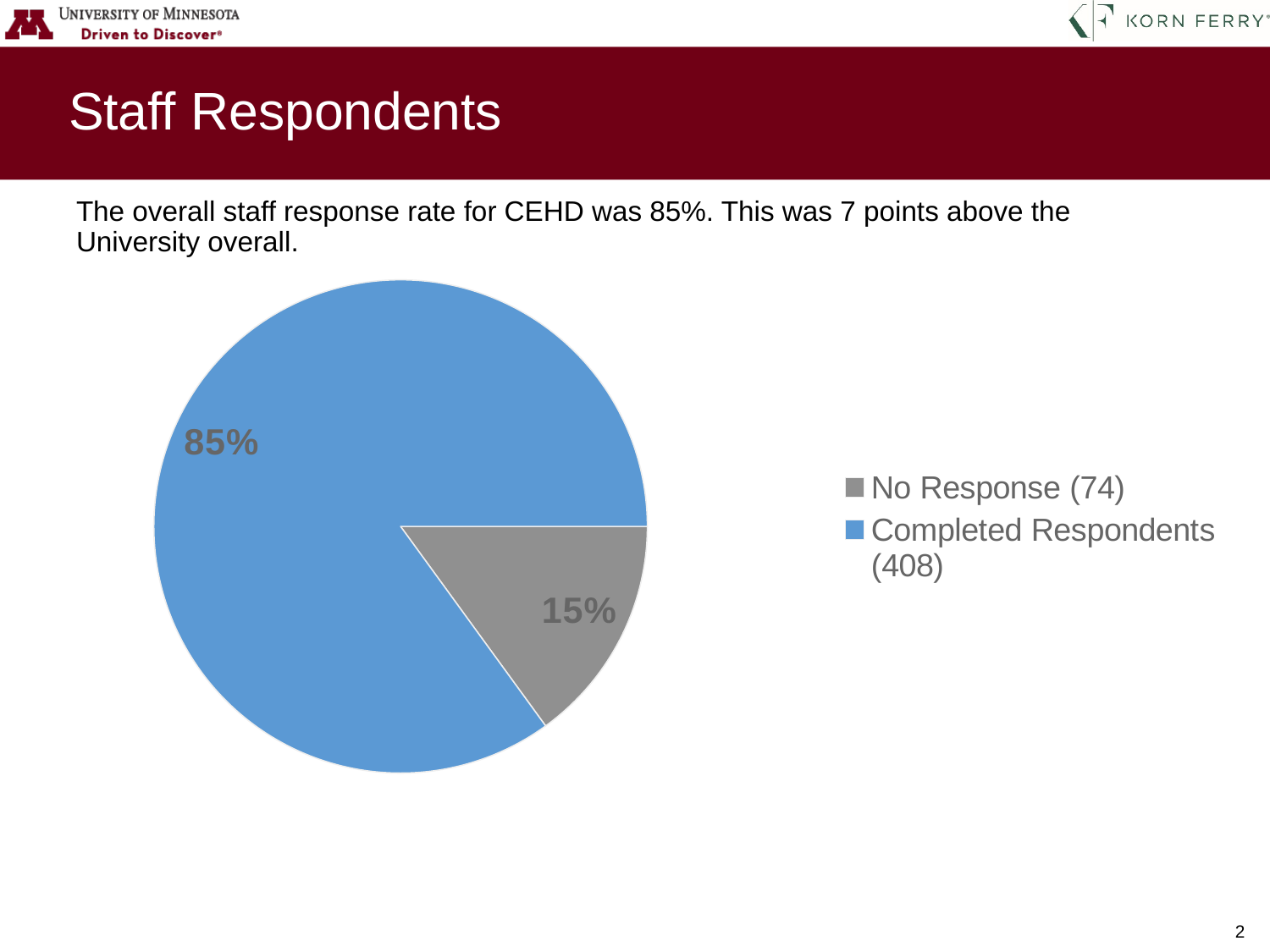
How many entries does the legend list? 2 What is the difference in percentage points between the Completed Respondents slice and the No Response slice? 70 percentage points Which slice of the pie is the smallest? No Response What colour is the Completed Respondents slice? blue Which slice of the pie is the largest? Completed Respondents How many slices does the pie chart have? 2 What count is shown in the legend for Completed Respondents? 408 What kind of chart is shown on the slide? pie chart What percentage of the pie is labelled for No Response? 15% What count is shown in the legend for No Response? 74 Which is larger, the Completed Respondents slice or the No Response slice? Completed Respondents What percentage of the pie is labelled for Completed Respondents? 85%